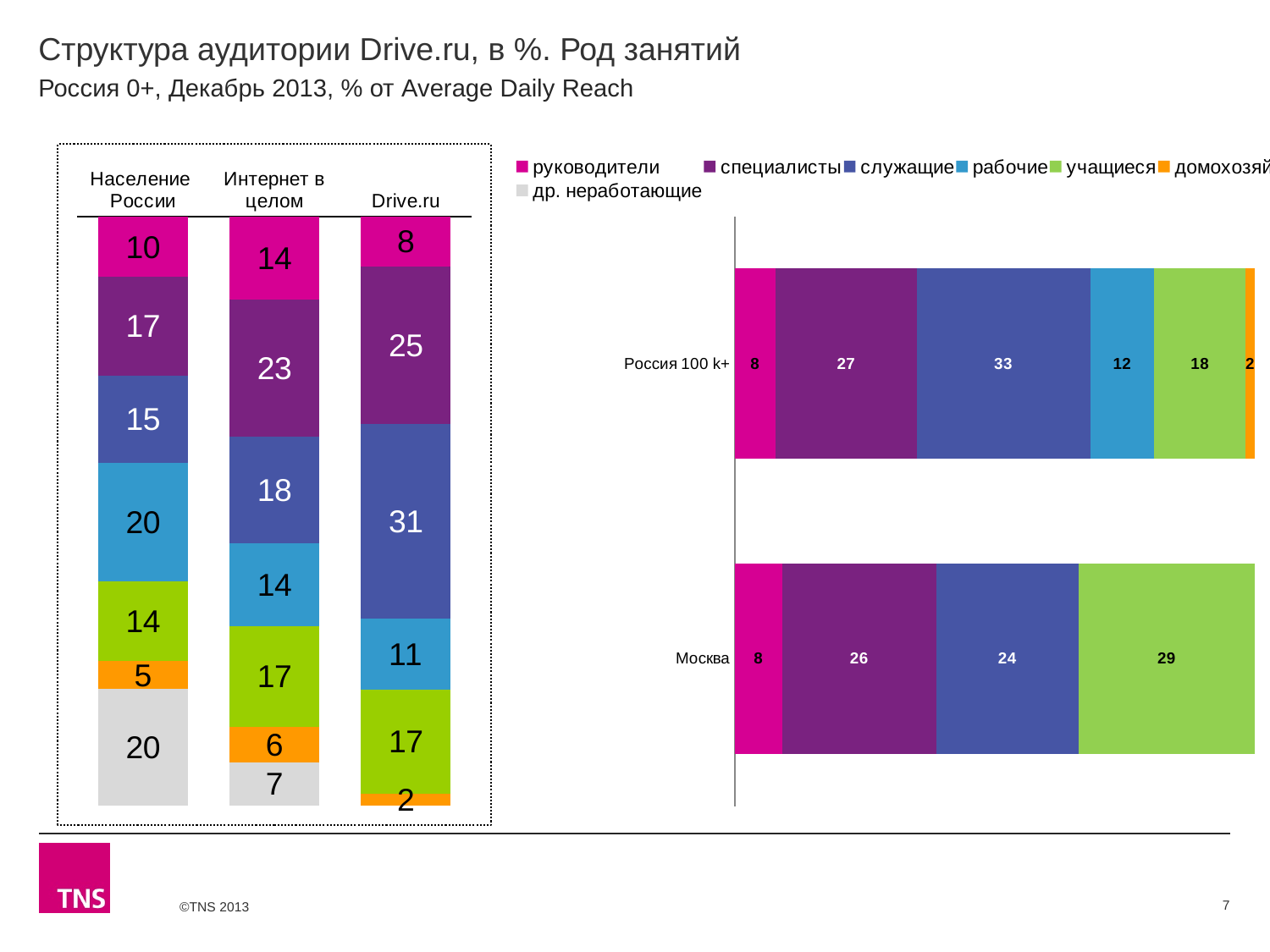
In the left chart, what is the difference between the специалисты value for Drive.ru and for Население России? 8 In the left chart, what is the value for служащие (blue) in the Drive.ru column? 31 In the left chart, what is the value for специалисты (purple) in the Интернет в целом column? 23 In the right chart, which is larger: the специалисты value for Россия 100 k+ or for Москва? Россия 100 k+ In the right chart, what is the value for учащиеся (green) for Москва? 29 In the right chart, what is the value for служащие (blue) for Россия 100 k+? 33 In the left chart, which segment is the smallest in the Население России column? домохозяйки How many series does the legend on the right list? 7 What type of chart is shown on the right side of the slide? Stacked bar chart In the right chart, what is the total of the Москва bar? 87 In the left chart, how many columns (audience groups) are shown? 3 In the left chart, which segment is the largest in the Drive.ru column? служащие